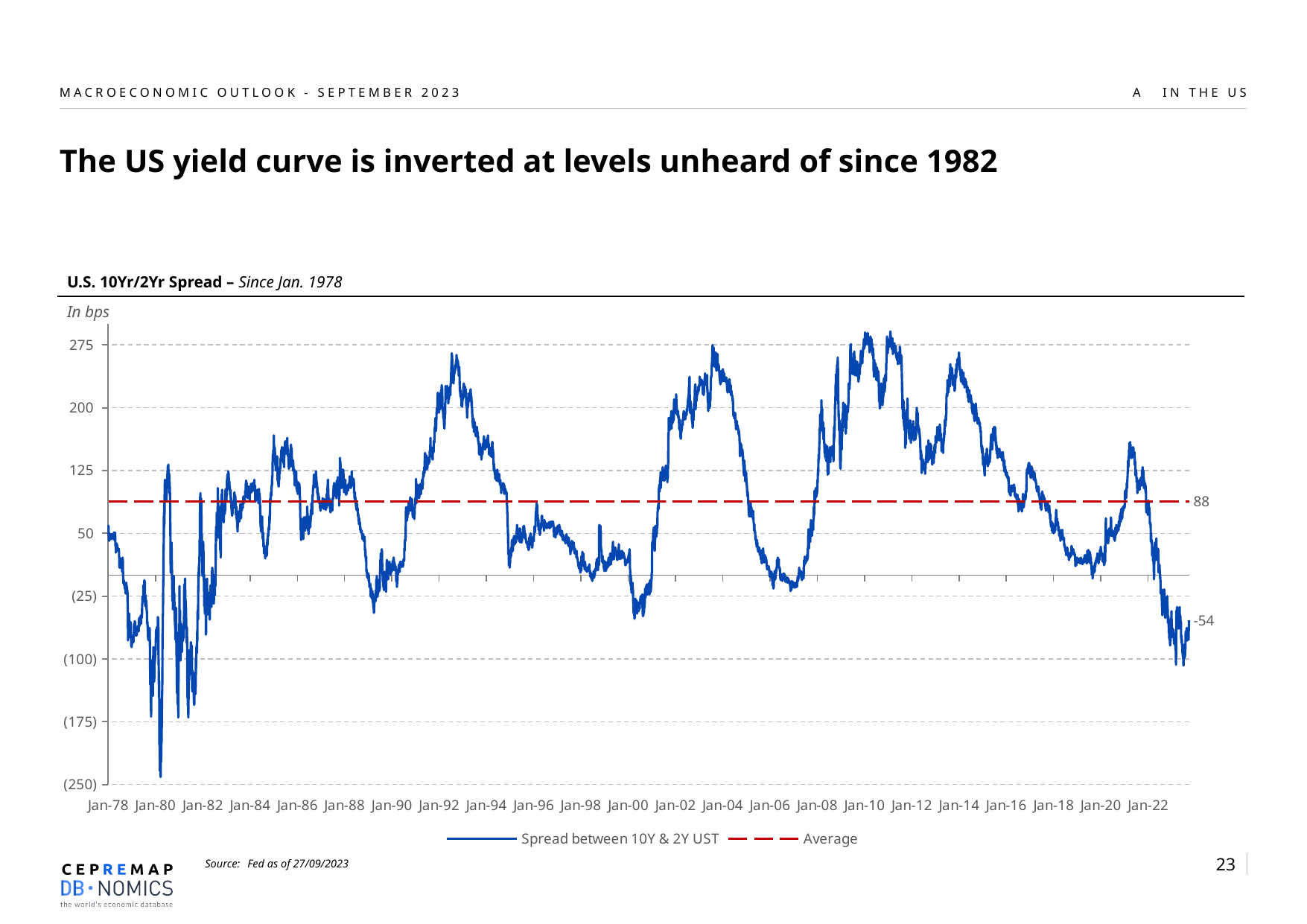
What is the latest labelled value of the spread between 10Y & 2Y UST? -54 Is the peak of the spread around Jan-92 greater or less than 200? greater How many series does the legend list? 2 By how many bps is the latest spread value (-54) below the average (88)? 142 Which is larger, the latest spread value or the average? the average Is the lowest value of the spread around 1980 greater or less than (175)? less Is the peak of the spread around Jan-10 greater or less than 200? greater What value is labelled for the Average line? 88 From its peak around 2021 to the end of the series, does the spread rise or fall? fall What is the title of the chart? U.S. 10Yr/2Yr Spread – Since Jan. 1978 What kind of chart is shown on the slide? line chart In what unit are the values on the chart expressed? bps